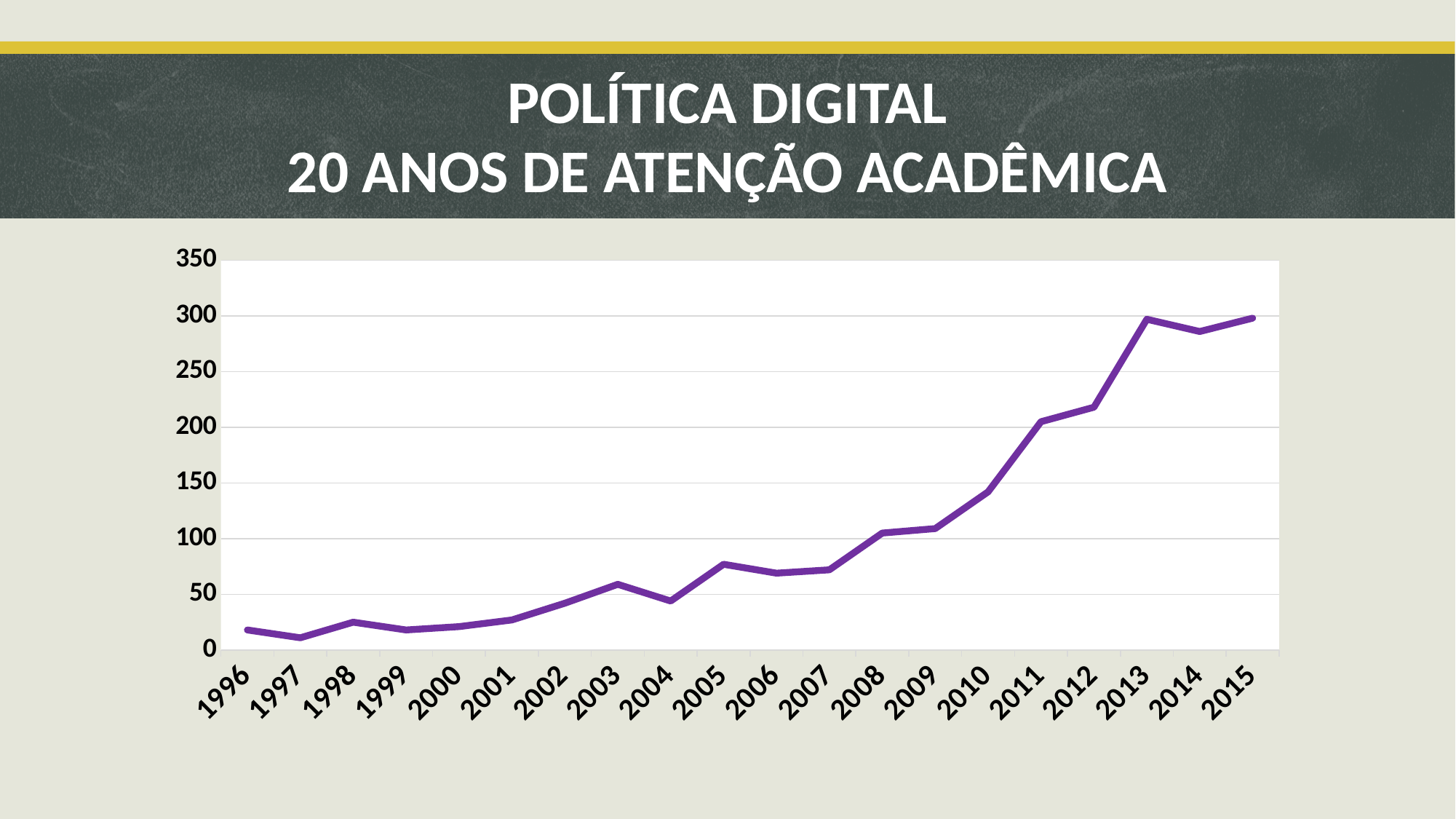
Is the value for 2004 greater or less than 50? less What kind of chart is shown on the slide? line chart Which year has the larger value, 2013 or 2010? 2013 Is the value for 2010 greater or less than 150? less Overall, do the values rise or fall from 1996 to 2015? rise Is the value for 2005 greater or less than 50? greater What is the title shown above the chart on the slide? POLÍTICA DIGITAL 20 ANOS DE ATENÇÃO ACADÊMICA Which year has the lowest value on the chart? 1997 Which year has the larger value, 2003 or 2004? 2003 How many years are plotted along the x axis of the chart? 20